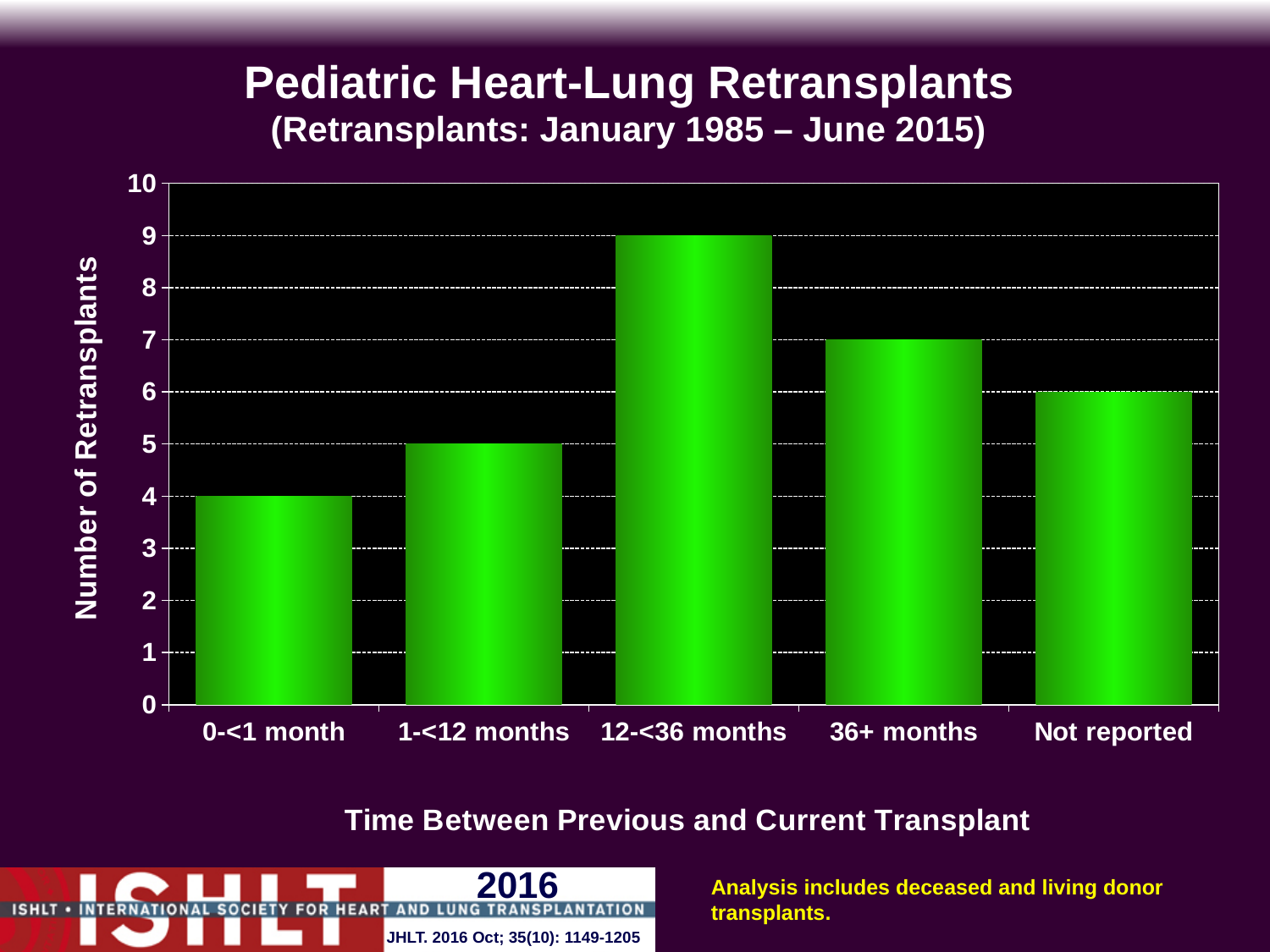
What is the number of retransplants for the 36+ months category? 7 Is the value for 1-<12 months greater or less than 8? less Which category has the highest number of retransplants? 12-<36 months Which category has the lowest number of retransplants? 0-<1 month What is the number of retransplants for the 0-<1 month category? 4 What type of chart is shown on the slide? bar chart What is the number of retransplants for the Not reported category? 6 What is the difference in number of retransplants between the 12-<36 months and 1-<12 months categories? 4 What is the label of the y axis? Number of Retransplants What is the number of retransplants for the 12-<36 months category? 9 Which has more retransplants, 36+ months or Not reported? 36+ months How many categories are shown on the x axis? 5